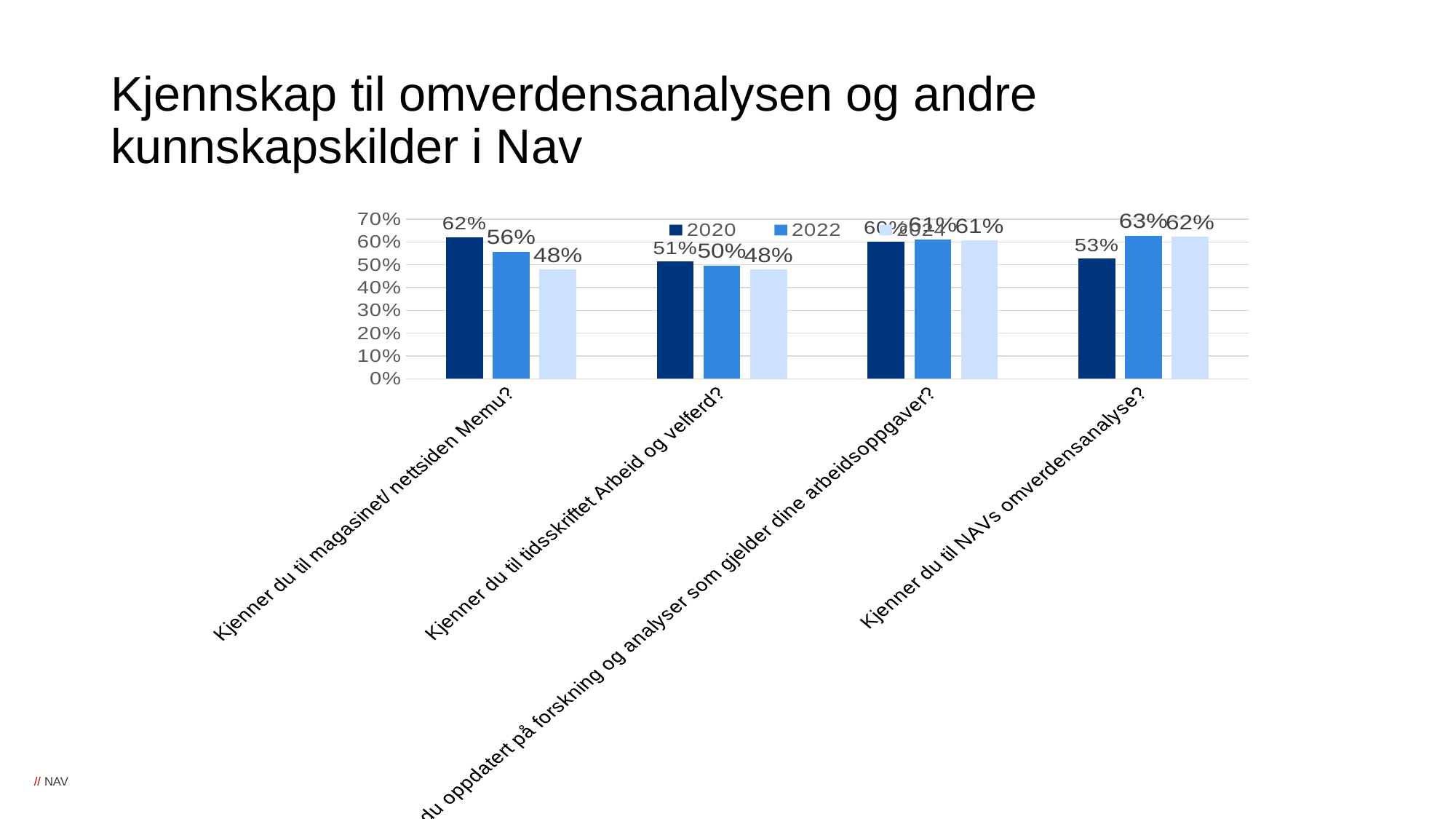
What is the 2022 value for "Kjenner du til magasinet/ nettsiden Memu?"? 56% What is the difference between the 2020 and 2022 values for "Kjenner du til magasinet/ nettsiden Memu?"? 6 percentage points What is the 2020 value for "Kjenner du til tidsskriftet Arbeid og velferd?"? 51% What kind of chart is shown on the slide? Bar chart Does the value for "Kjenner du til magasinet/ nettsiden Memu?" rise or fall from 2020 to 2022? Fall What is the difference between the 2020 and 2022 values for "Kjenner du til NAVs omverdensanalyse?"? 10 percentage points Which category has the highest 2020 value? Kjenner du til magasinet/ nettsiden Memu? Which category has the lowest 2022 value? Kjenner du til tidsskriftet Arbeid og velferd? Which is larger: the 2020 value for "Kjenner du til NAVs omverdensanalyse?" or the 2020 value for "Kjenner du til magasinet/ nettsiden Memu?"? Kjenner du til magasinet/ nettsiden Memu? What is the 2022 value for "Kjenner du til NAVs omverdensanalyse?"? 63% What is the 2020 value for "Kjenner du til magasinet/ nettsiden Memu?"? 62% How many categories are shown on the x axis? 4